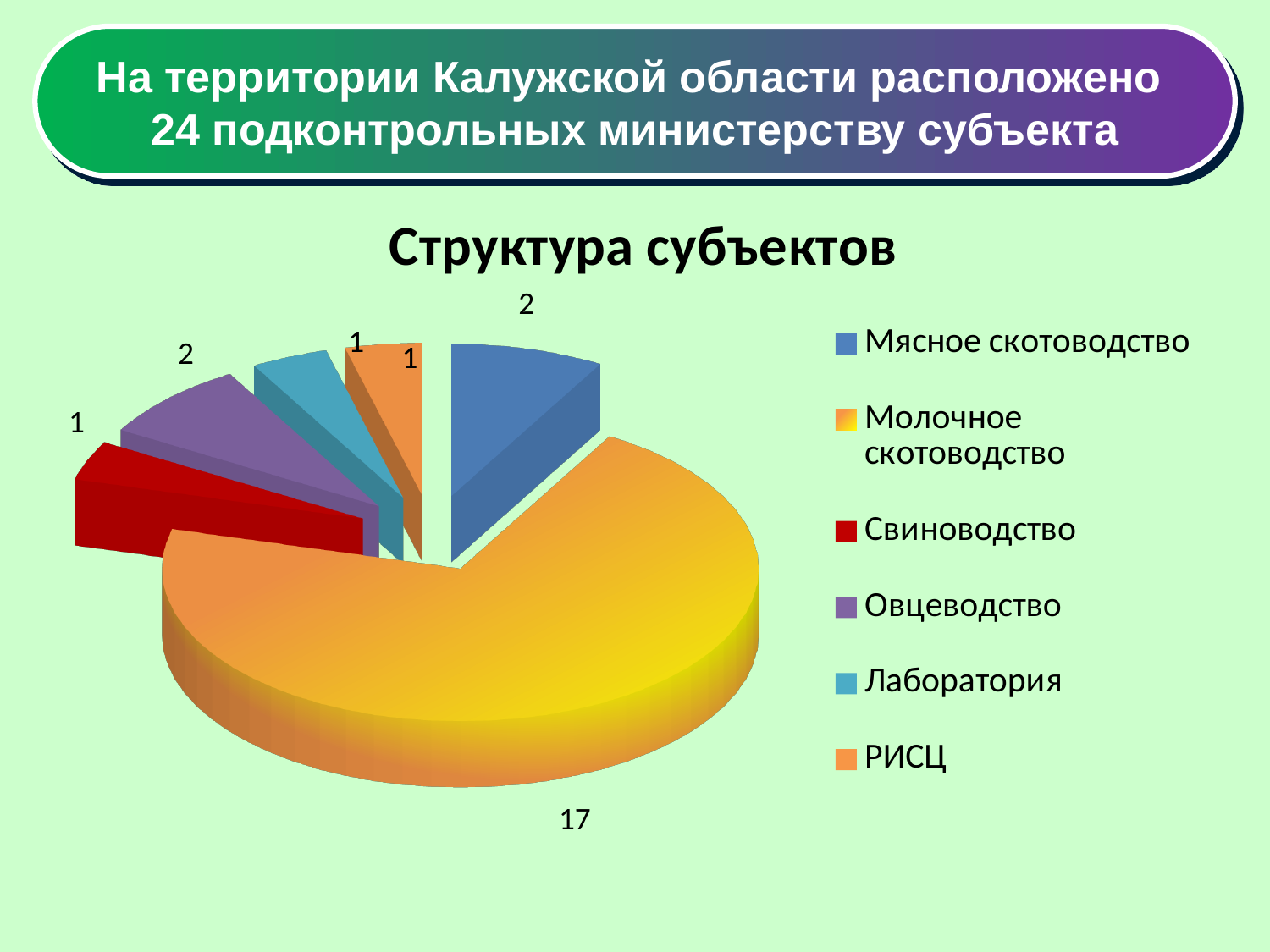
What is the difference between the values for Молочное скотоводство and Мясное скотоводство? 15 What is the value for Овцеводство? 2 What is the total of all slices in the pie chart? 24 What is the value for Свиноводство? 1 Which category has the largest slice of the pie? Молочное скотоводство How many categories does the legend of the pie chart list? 6 What kind of chart is shown on the slide? pie chart Which is larger, the value for Овцеводство or the value for Лаборатория? Овцеводство What is the title of the chart? Структура субъектов What colour is the slice for Свиноводство? red What is the value for Мясное скотоводство? 2 What is the value for Молочное скотоводство? 17